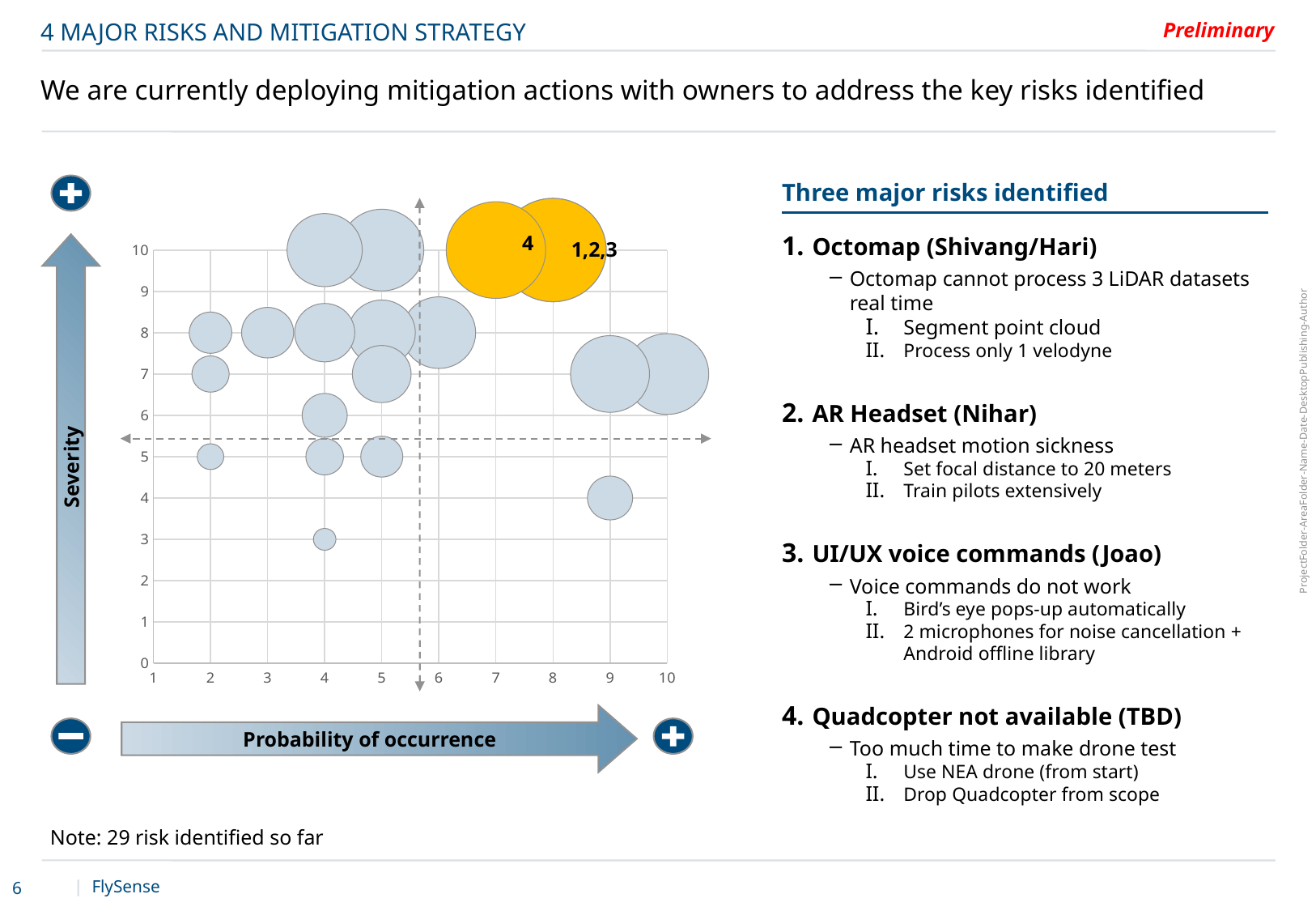
What is the label of the horizontal axis of the chart? Probability of occurrence What severity value does the bubble labelled "4" sit at? 10 What kind of chart is shown on the slide? Bubble chart What is the lowest severity value at which any bubble is plotted? 3 What severity value does the bubble labelled "1,2,3" sit at? 10 What is the highest probability of occurrence value at which any bubble is plotted? 10 What is the difference in probability of occurrence between the bubble labelled "1,2,3" and the bubble labelled "4"? 1 What is the label of the vertical axis of the chart? Severity Is the severity of the bubble plotted at probability 9 and severity 4 greater or less than 5? less What probability of occurrence value does the bubble labelled "4" sit at? 7 What probability of occurrence value does the bubble labelled "1,2,3" sit at? 8 Which bubble has the higher probability of occurrence, the one labelled "4" or the one labelled "1,2,3"? 1,2,3